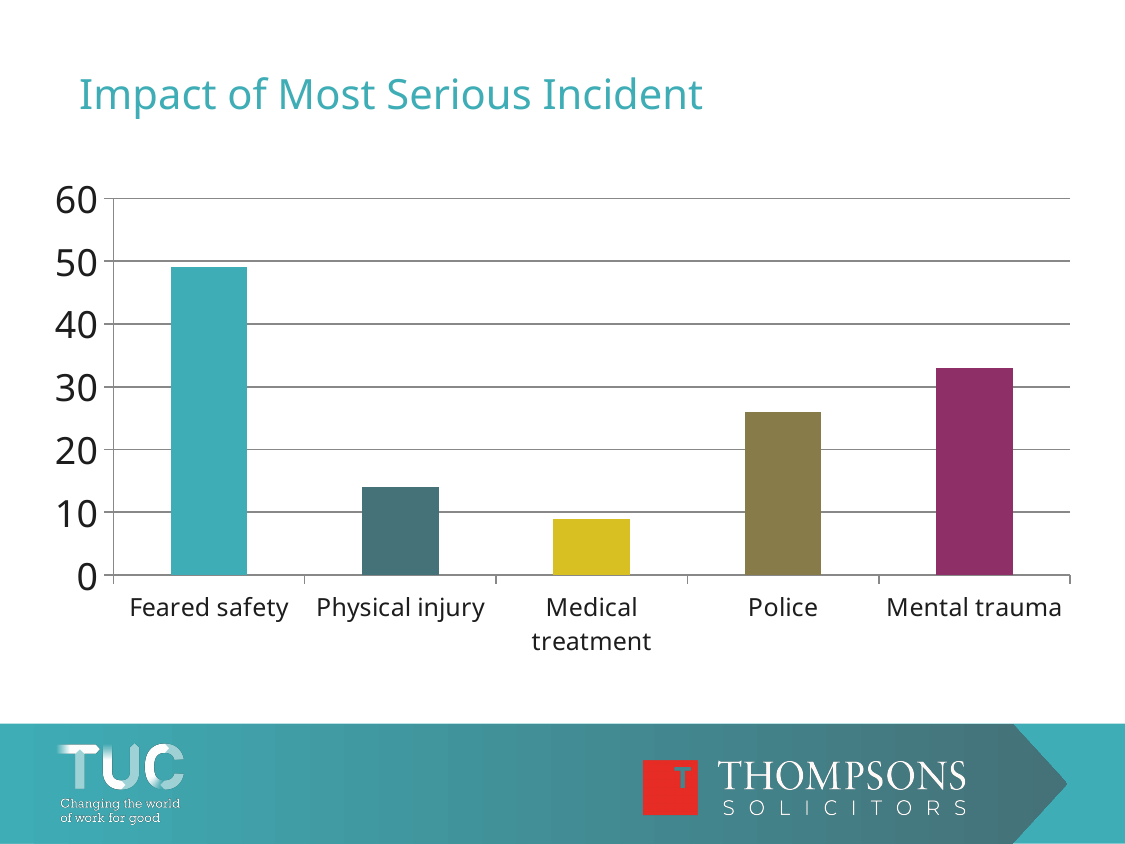
Is the value for Mental trauma greater or less than 40? less What is the title of the chart? Impact of Most Serious Incident What kind of chart is shown on the slide? bar chart Which category has the lowest value? Medical treatment Which category has the highest value? Feared safety Which is larger, the value for Physical injury or the value for Medical treatment? Physical injury Is the value for Feared safety greater or less than 40? greater Is the value for Physical injury greater or less than 20? less How many categories are shown on the x axis of the chart? 5 Which is larger, the value for Police or the value for Mental trauma? Mental trauma